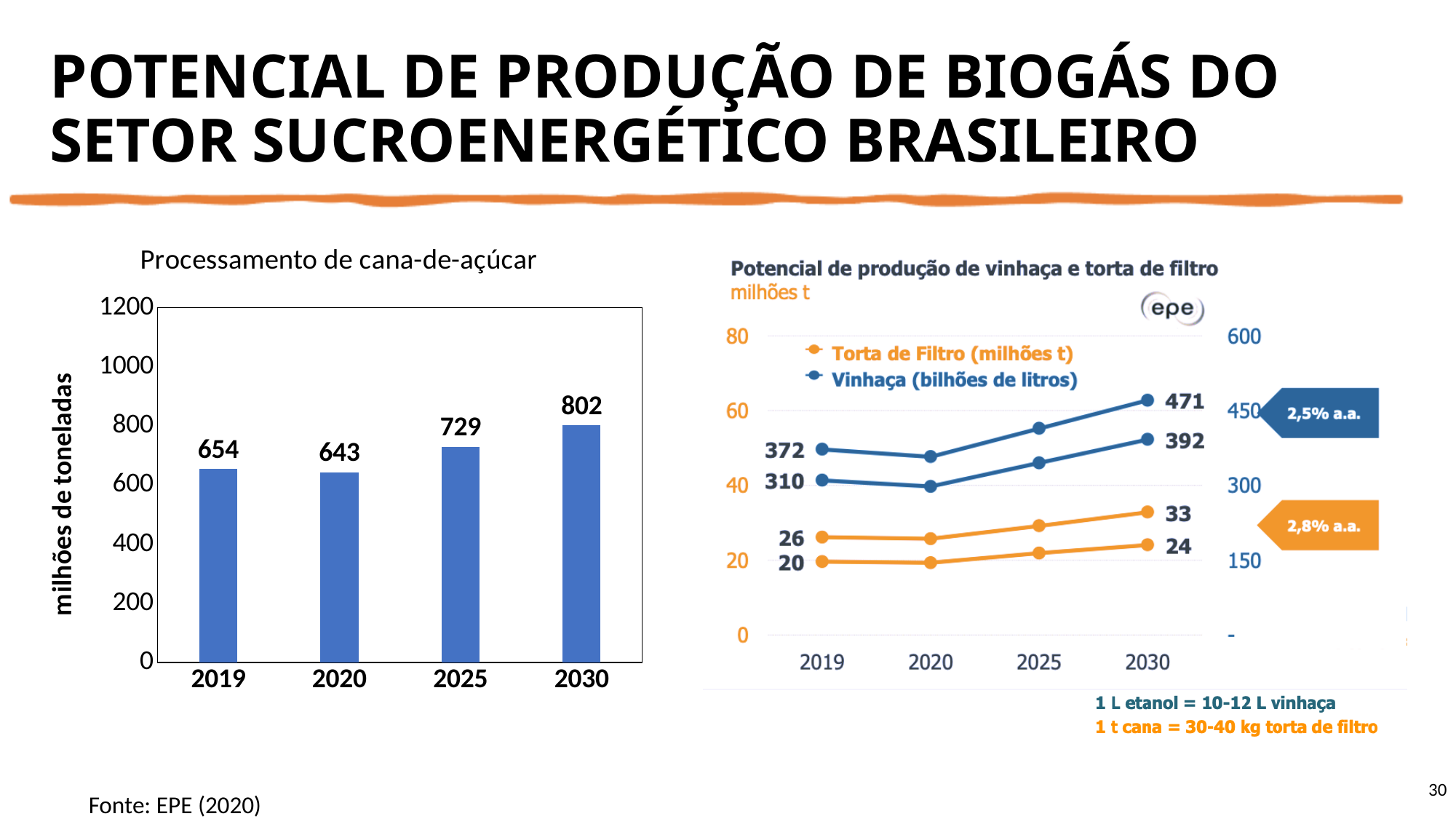
In the bar chart 'Processamento de cana-de-açúcar', what is the difference between the values for 2030 and 2025? 73 In the bar chart 'Processamento de cana-de-açúcar', which year has the highest value? 2030 In the bar chart 'Processamento de cana-de-açúcar', what is the value for 2030? 802 In the right chart 'Potencial de produção de vinhaça e torta de filtro', what is the labelled value of the lower Torta de Filtro line in 2019? 20 In the bar chart 'Processamento de cana-de-açúcar', how many years are shown on the x axis? 4 In the bar chart 'Processamento de cana-de-açúcar', which year has the lowest value? 2020 In the right chart 'Potencial de produção de vinhaça e torta de filtro', what is the labelled value of the upper Vinhaça line in 2030? 471 In the right chart 'Potencial de produção de vinhaça e torta de filtro', how many series does the legend list? 2 In the bar chart 'Processamento de cana-de-açúcar', what is the y-axis label? milhões de toneladas What type of chart is the left chart 'Processamento de cana-de-açúcar'? bar chart In the right chart 'Potencial de produção de vinhaça e torta de filtro', does the upper Vinhaça line rise or fall between 2020 and 2030? rise In the bar chart 'Processamento de cana-de-açúcar', what is the value for 2019? 654